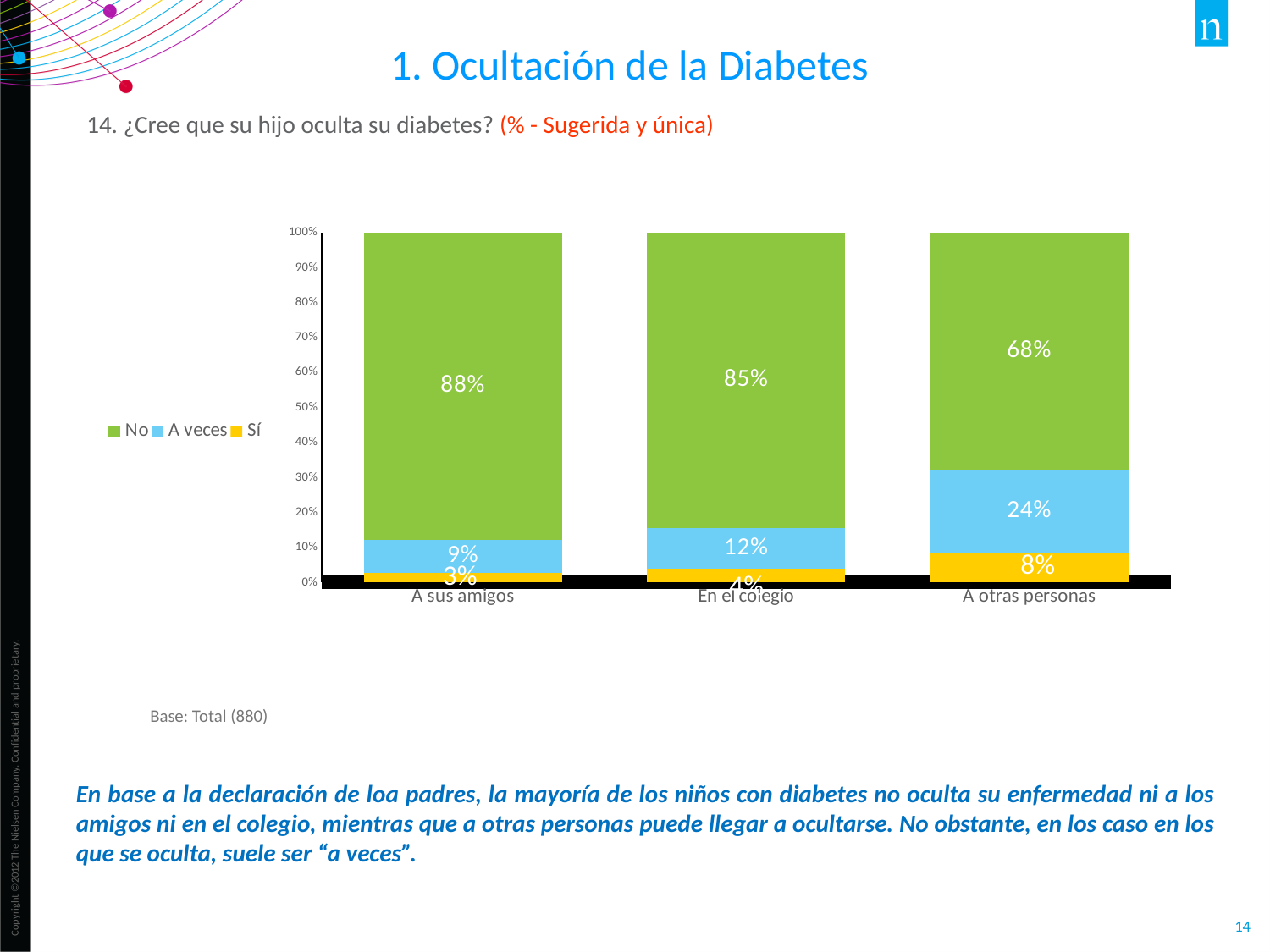
What is the value of 'Sí' for 'A otras personas'? 8% What is the value of 'No' for 'En el colegio'? 85% What kind of chart is shown on the slide? Stacked bar chart What is the value of 'No' for 'A otras personas'? 68% How many series does the legend list? 3 What is the value of 'A veces' for 'En el colegio'? 12% Which series is shown in green in the legend? No How many categories are shown on the x axis? 3 Which category has the lowest value for 'No'? A otras personas What is the difference between the 'No' values for 'A sus amigos' and 'A otras personas'? 20% What is the value of 'No' for 'A sus amigos'? 88% What is the value of 'A veces' for 'A otras personas'? 24%